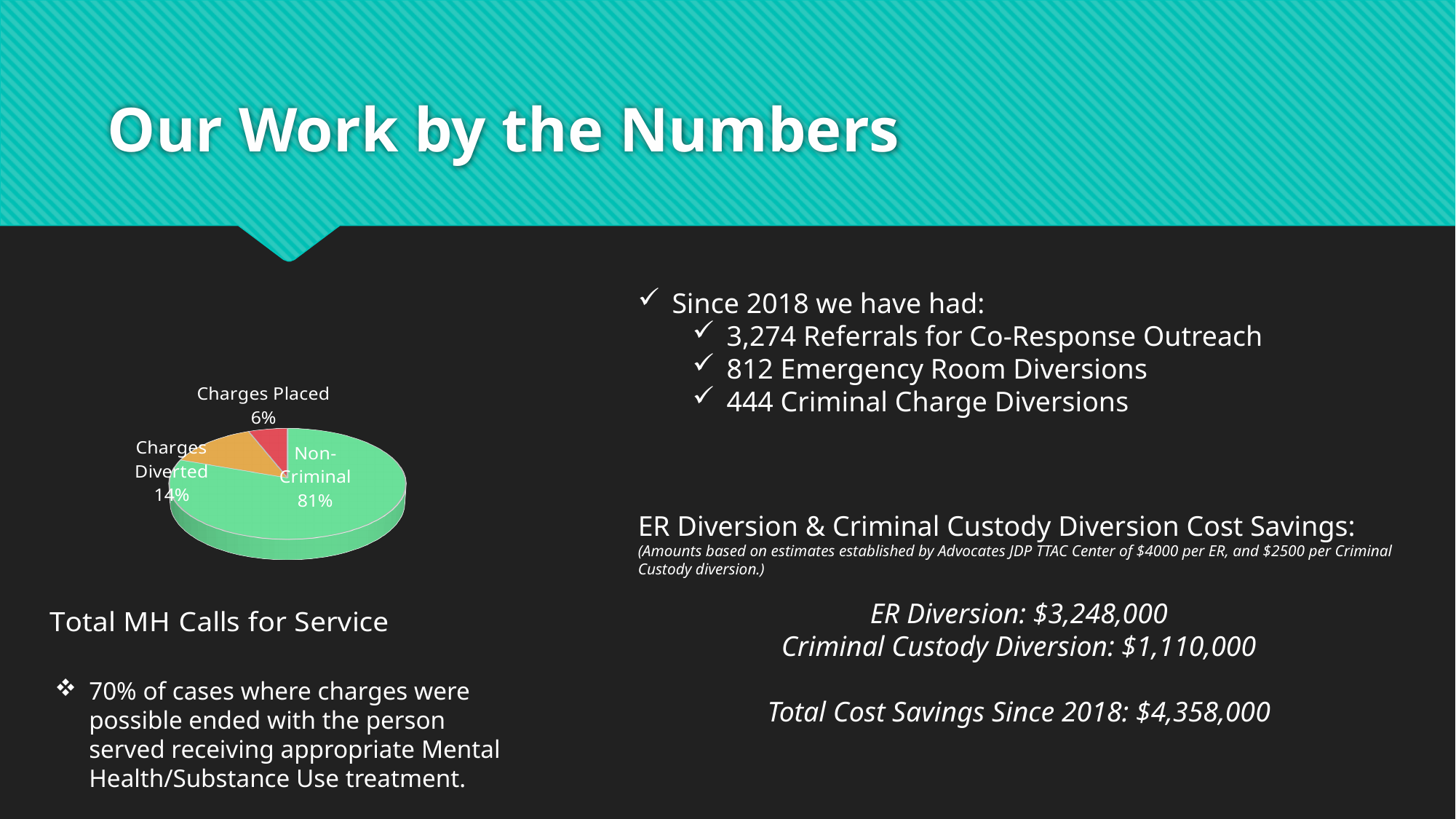
What colour is the Charges Placed slice of the pie chart? red Which slice of the pie chart is the largest? Non-Criminal What is the title shown below the pie chart? Total MH Calls for Service What kind of chart is shown on the slide? pie chart What is the difference in percentage points between the Charges Diverted and Charges Placed slices? 8 Which slice of the pie chart is the smallest? Charges Placed What is the difference in percentage points between the Non-Criminal and Charges Diverted slices? 67 How many slices does the pie chart have? 3 What share of the pie chart is Charges Diverted? 14% Which is larger in the pie chart, Charges Diverted or Charges Placed? Charges Diverted What share of the pie chart is Charges Placed? 6% What share of the pie chart is Non-Criminal? 81%